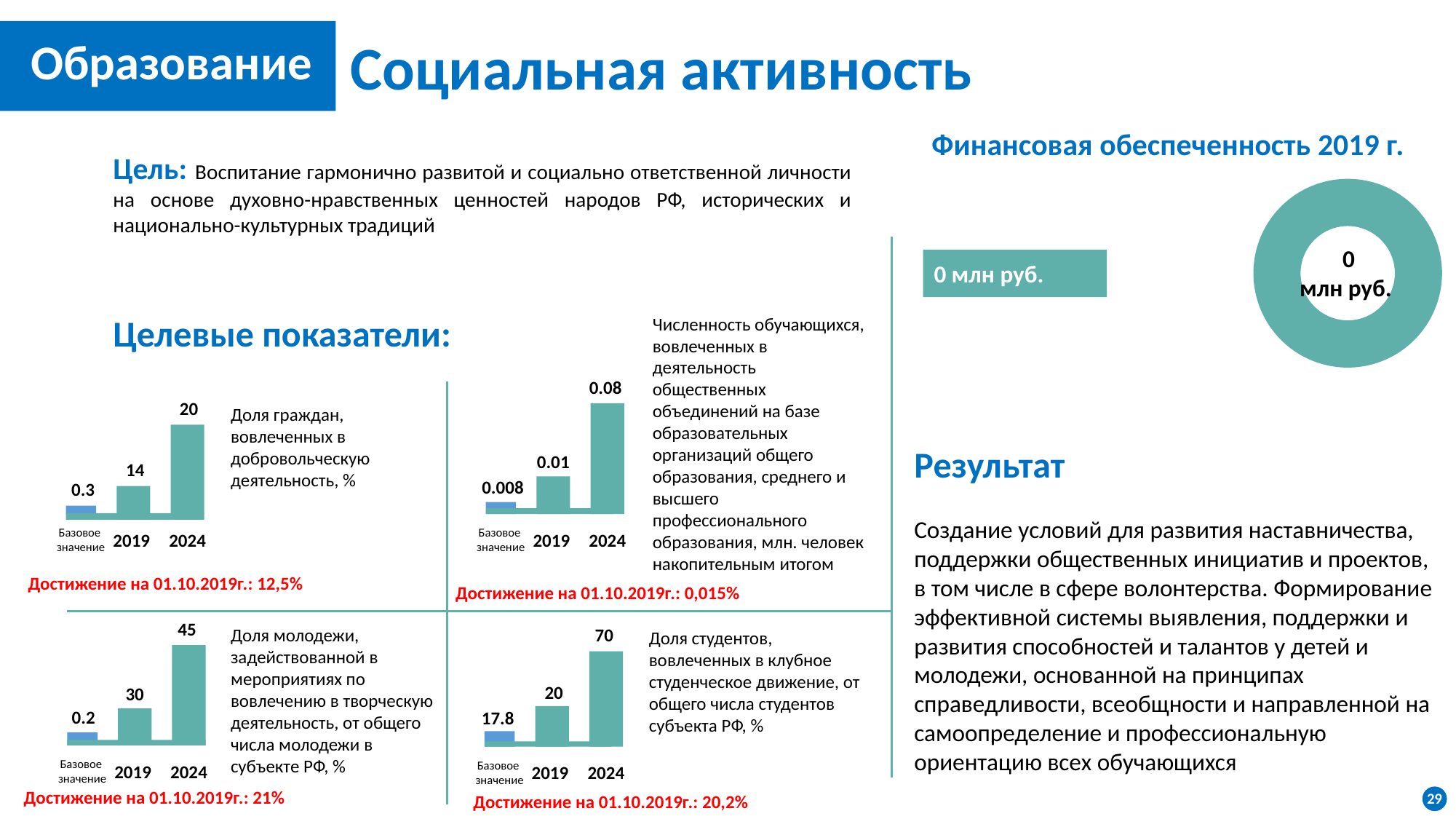
What value is shown in the centre of the donut chart under Финансовая обеспеченность 2019 г.? 0 млн руб. In the top-left bar chart (Доля граждан, вовлеченных в добровольческую деятельность, %), what is the value for 2024? 20 In the bar chart about Доля студентов, вовлеченных в клубное студенческое движение (%), do the values rise or fall from the base value to 2024? rise In the bar chart about Численность обучающихся, вовлеченных в деятельность общественных объединений (млн. человек), what is the value for 2019? 0.01 In the bottom-left bar chart (Доля молодежи, задействованной в мероприятиях по вовлечению в творческую деятельность, %), what is the value for 2024? 45 How many categories does the top-left bar chart (Доля граждан, вовлеченных в добровольческую деятельность, %) show? 3 In the top-left bar chart (Доля граждан, вовлеченных в добровольческую деятельность, %), what is the difference between the 2024 and 2019 values? 6 In the top-left bar chart (Доля граждан, вовлеченных в добровольческую деятельность, %), what is the base value (Базовое значение)? 0.3 In the bottom-left bar chart (Доля молодежи, задействованной в мероприятиях по вовлечению в творческую деятельность, %), which category has the lowest value? Базовое значение In the bar chart about Доля студентов, вовлеченных в клубное студенческое движение (%), what is the difference between the 2024 and 2019 values? 50 In the bar chart about Численность обучающихся, вовлеченных в деятельность общественных объединений (млн. человек), which category has the highest value? 2024 In the bar chart about Доля студентов, вовлеченных в клубное студенческое движение (%), what is the base value (Базовое значение)? 17.8